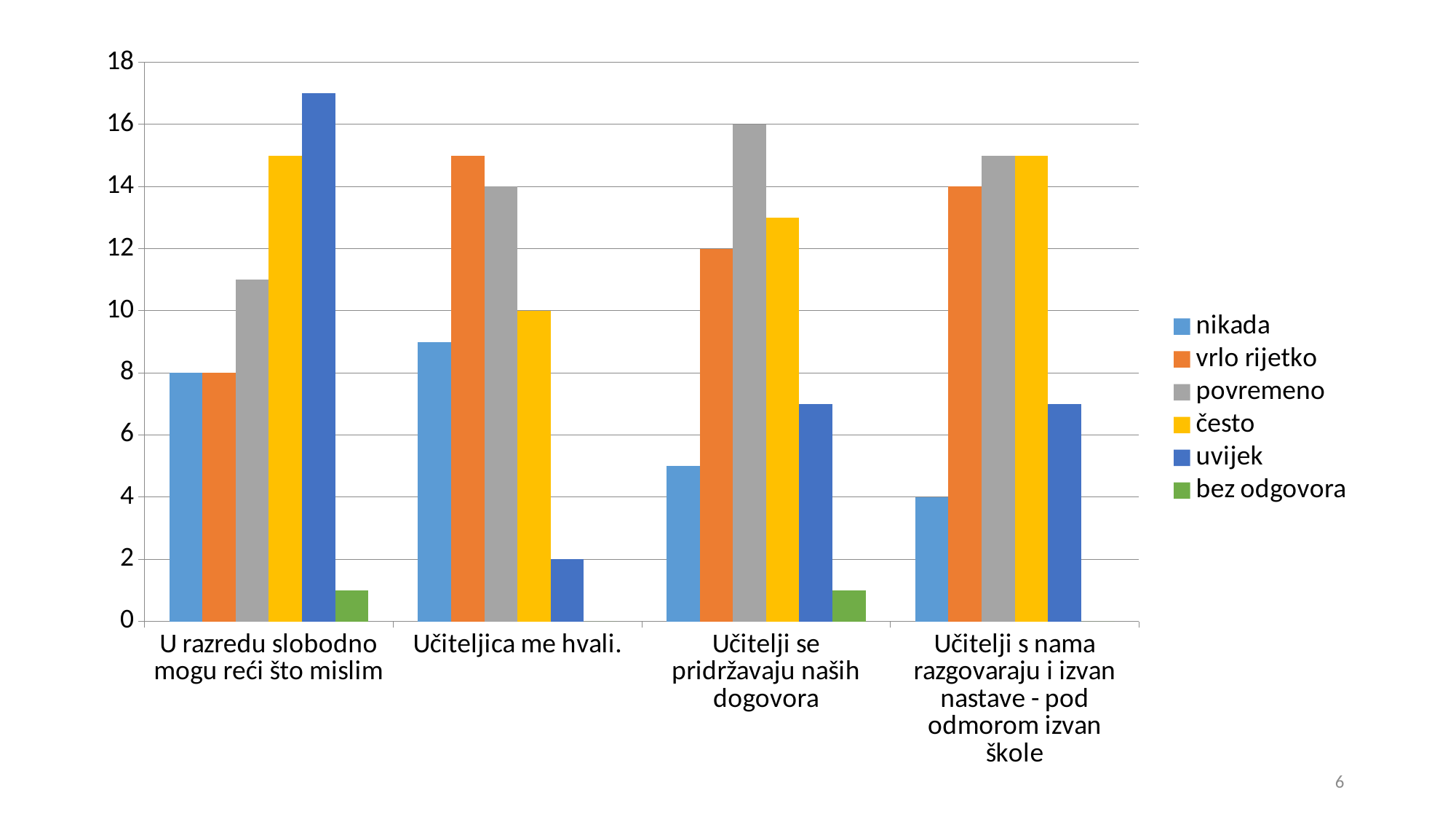
In the category 'Učitelji se pridržavaju naših dogovora', which is larger: 'vrlo rijetko' or 'uvijek'? vrlo rijetko Which series has the lowest value in the category 'Učiteljica me hvali.'? bez odgovora What is the value for 'povremeno' in the category 'Učiteljica me hvali.'? 14 What is the value for 'nikada' in the category 'Učitelji s nama razgovaraju i izvan nastave - pod odmorom izvan škole'? 4 What is the value for 'nikada' in the category 'U razredu slobodno mogu reći što mislim'? 8 What is the difference between 'povremeno' and 'često' in the category 'Učiteljica me hvali.'? 4 Which series has the highest value in the category 'U razredu slobodno mogu reći što mislim'? uvijek What kind of chart is shown on the slide? bar chart Is the value for 'uvijek' in the category 'U razredu slobodno mogu reći što mislim' greater or less than 16? greater How many series does the legend list? 6 How many categories are shown on the x axis? 4 What is the value for 'povremeno' in the category 'Učitelji se pridržavaju naših dogovora'? 16